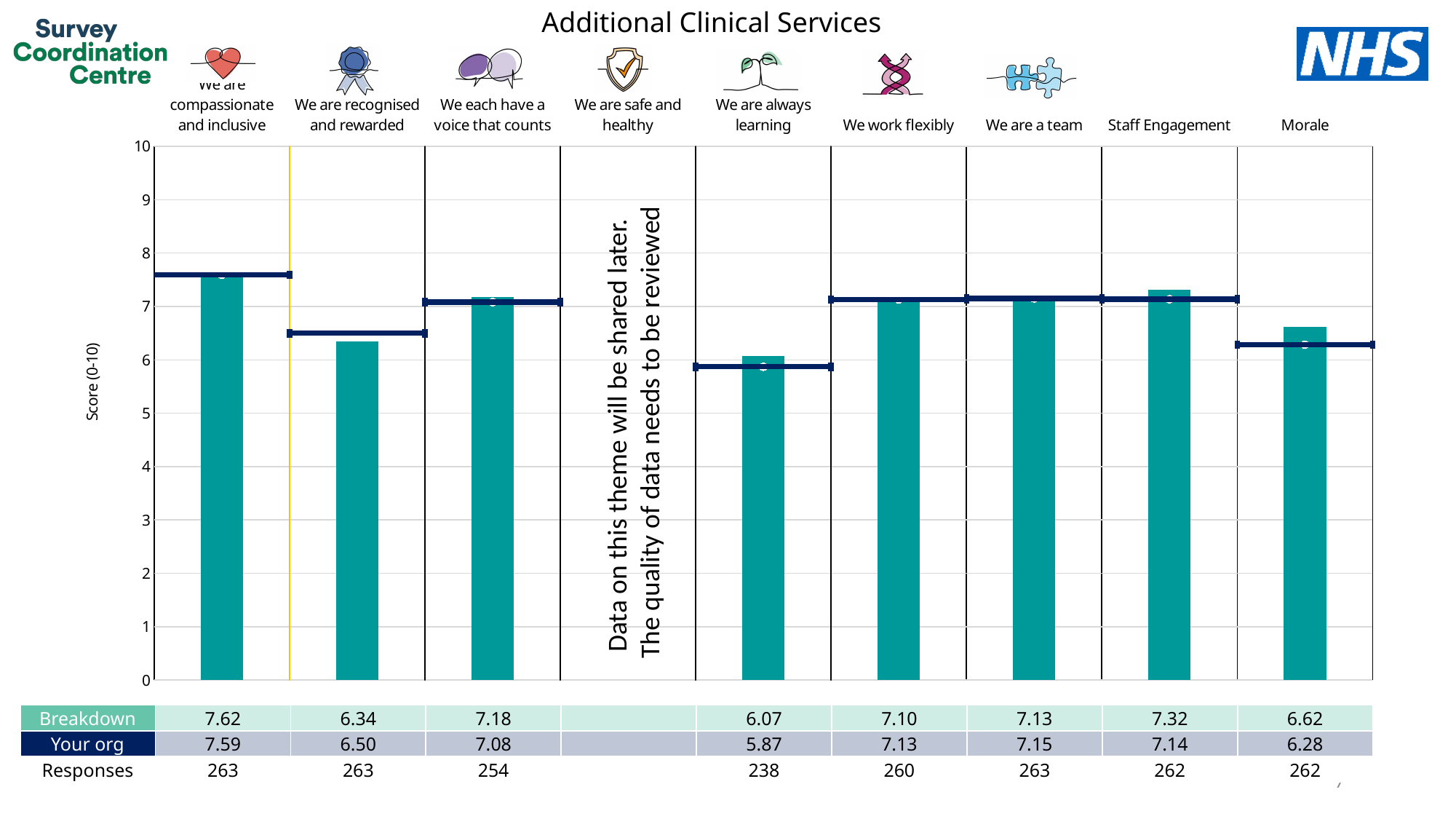
Is the Breakdown score for 'We are always learning' greater or less than 7? less For 'We are recognised and rewarded', which is larger: the Breakdown score or the Your org score? Your org Which theme has no data shown on the chart? We are safe and healthy What is the Your org score for 'We are always learning'? 5.87 What kind of chart is shown on the slide? Bar chart Which theme has the highest Breakdown score? We are compassionate and inclusive What is the Breakdown score for 'We are compassionate and inclusive'? 7.62 Which theme has the lowest Breakdown score? We are always learning How many teal bars are plotted on the chart? 8 What is the title of the chart? Additional Clinical Services What is the difference between the Breakdown and Your org scores for Morale? 0.34 How many responses are recorded for 'We each have a voice that counts'? 254